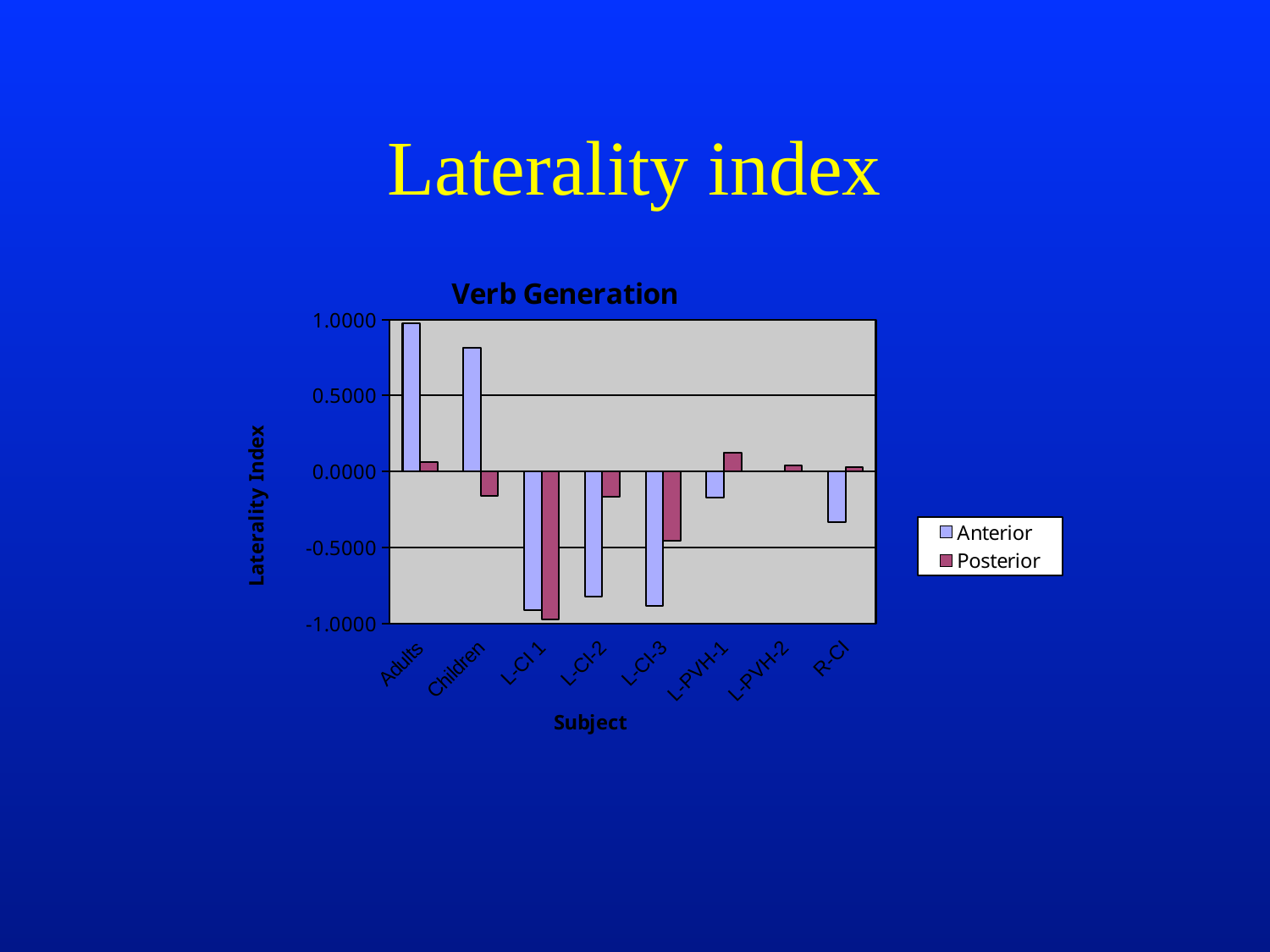
Is the Anterior value for Children greater or less than 0.5000? greater What is the title of the chart? Verb Generation For Adults, which is larger, the Anterior or the Posterior value? Anterior What is the label of the y axis? Laterality Index Which subject has the highest Anterior value? Adults How many series does the legend of the Verb Generation chart list? 2 Is the Anterior value for R-CI greater or less than -0.5000? greater Is the Anterior value for L-CI 1 greater or less than -0.5000? less Which subject has the lowest Posterior value? L-CI 1 How many subjects are shown on the x axis of the Verb Generation chart? 8 What kind of chart is shown on the slide? bar chart